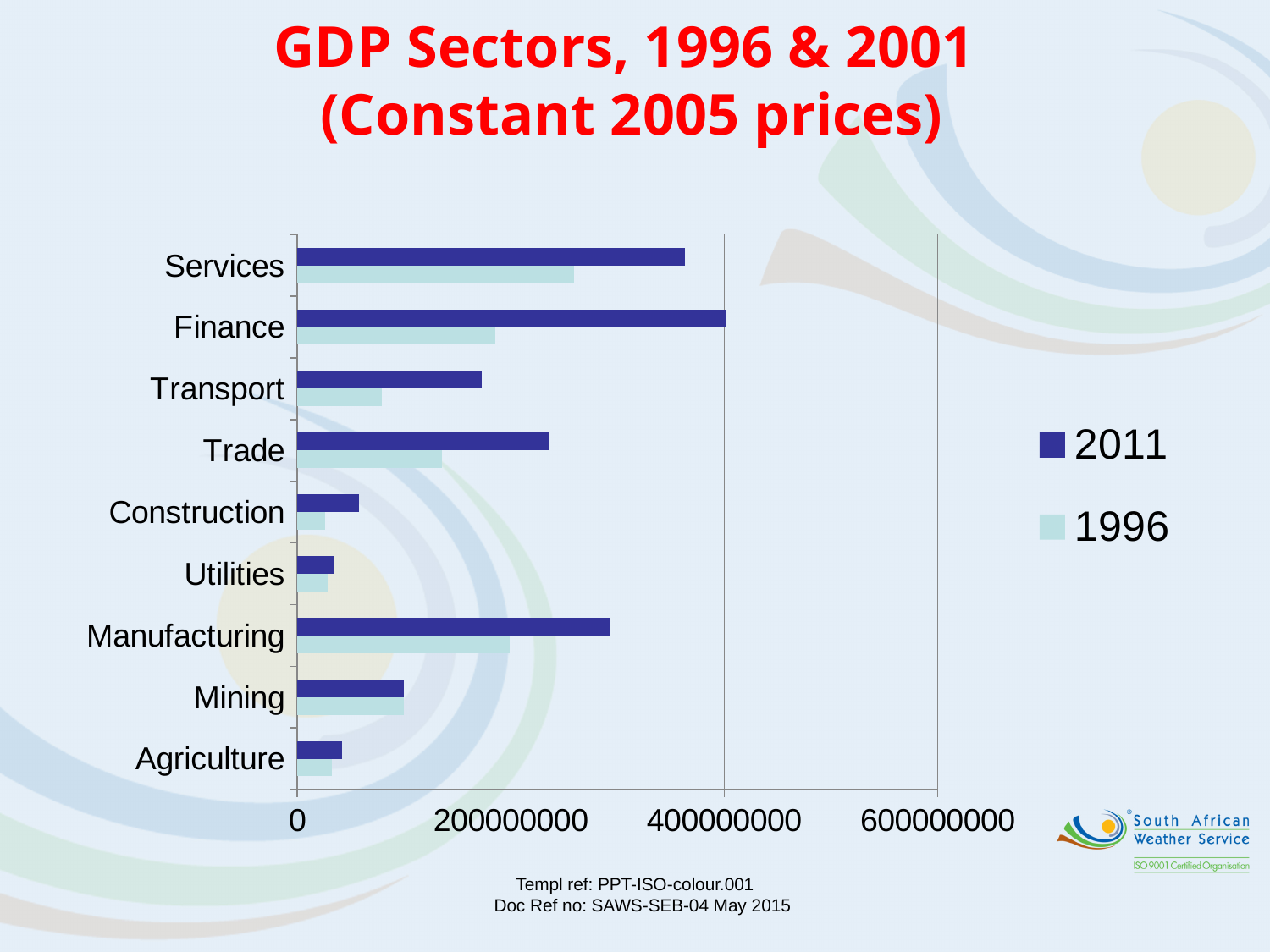
How many series does the legend list? 2 Is the 2011 value for Trade greater or less than 200000000? greater Which series is shown in dark blue in the legend? 2011 Which has the larger 2011 value: Trade or Transport? Trade How many sectors are shown on the chart? 9 Is the 1996 value for Finance greater or less than 200000000? less Is the 2011 value for Services greater or less than 200000000? greater Which sector has the highest value for 1996? Services What kind of chart is shown on the slide? Bar chart For Services, which is larger: the 2011 value or the 1996 value? 2011 Which sector has the highest value for 2011? Finance